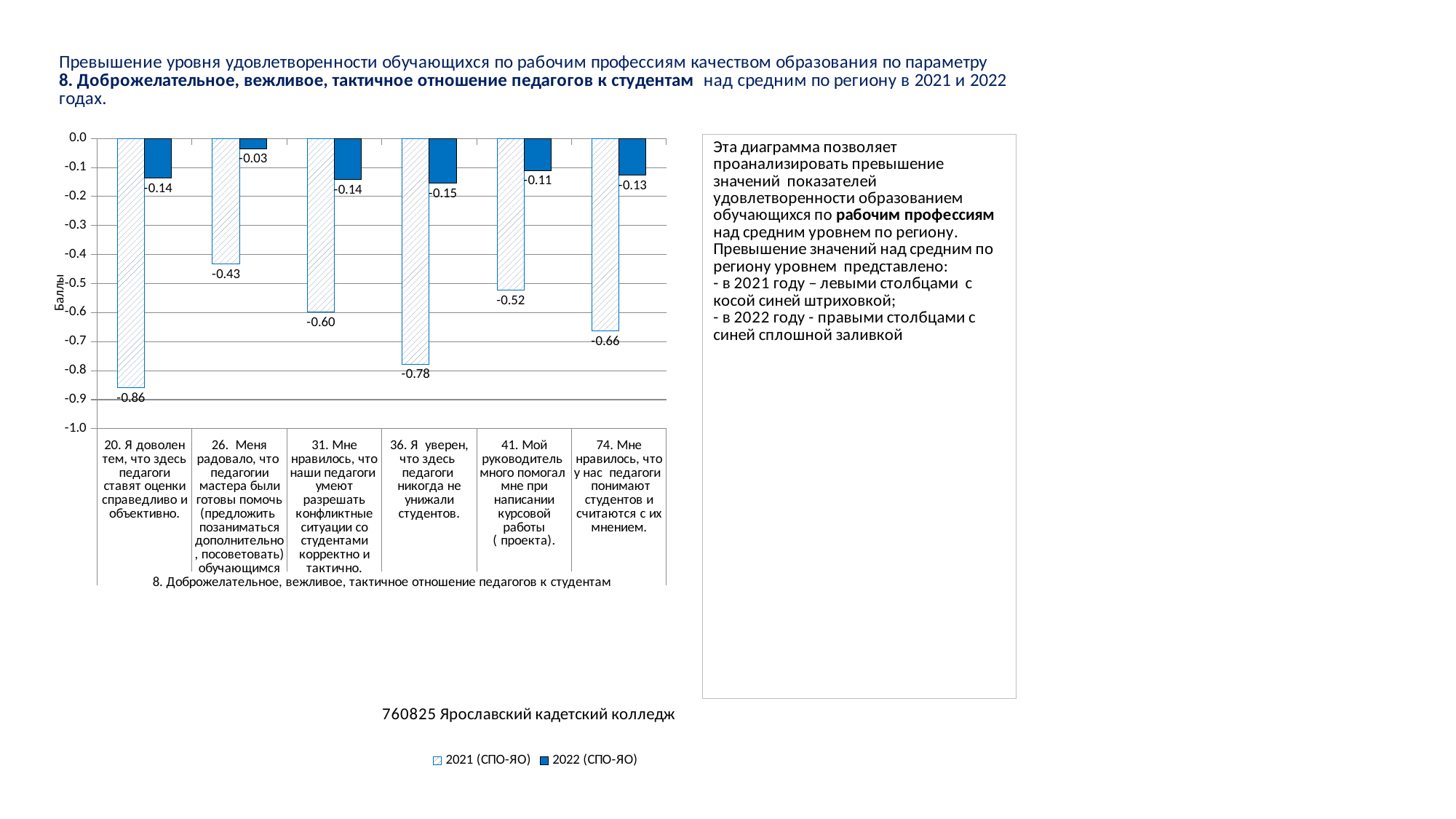
Which category has the lowest 2021 (СПО-ЯО) value? 20. Я доволен тем, что здесь педагоги ставят оценки справедливо и объективно. How many categories are shown on the x axis of the chart? 6 What is the 2021 (СПО-ЯО) value for category 20 ("Я доволен тем, что здесь педагоги ставят оценки справедливо и объективно")? -0.86 What is the label of the vertical axis of the chart? Баллы How many series does the chart legend list? 2 Which is larger: the 2021 value for category 26 or the 2021 value for category 31? Category 26 (-0.43) Which category has the highest 2022 (СПО-ЯО) value? 26. Меня радовало, что педагоги мастера были готовы помочь (предложить позаниматься дополнительно, посоветовать) обучающимся What is the 2022 (СПО-ЯО) value for category 26 ("Меня радовало, что педагоги мастера были готовы помочь...")? -0.03 What is the 2021 (СПО-ЯО) value for category 36 ("Я уверен, что здесь педагоги никогда не унижали студентов")? -0.78 What is the difference between the 2021 and 2022 values for category 74 ("Мне нравилось, что у нас педагоги понимают студентов и считаются с их мнением")? 0.53 What type of chart is shown on the slide? Bar chart What is the 2022 (СПО-ЯО) value for category 41 ("Мой руководитель много помогал мне при написании курсовой работы")? -0.11